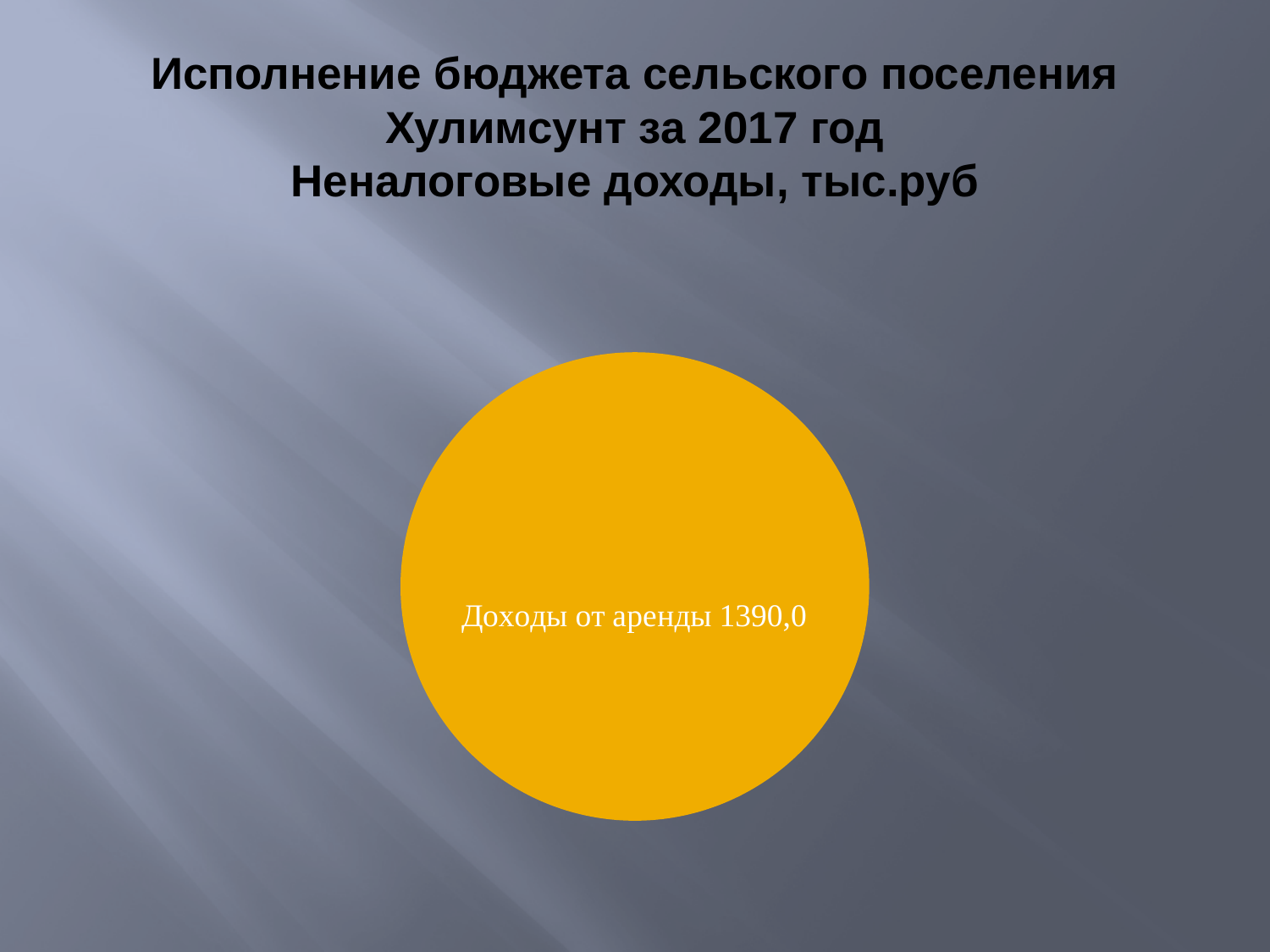
How many slices does the pie chart have? 1 Is the value for Доходы от аренды greater or less than 1000? greater What kind of chart is shown on the slide? pie chart What is the label of the only slice in the pie chart? Доходы от аренды What colour is the pie chart slice? yellow/orange What is the value for Доходы от аренды? 1390,0 What share of the pie does the Доходы от аренды slice represent? 100%